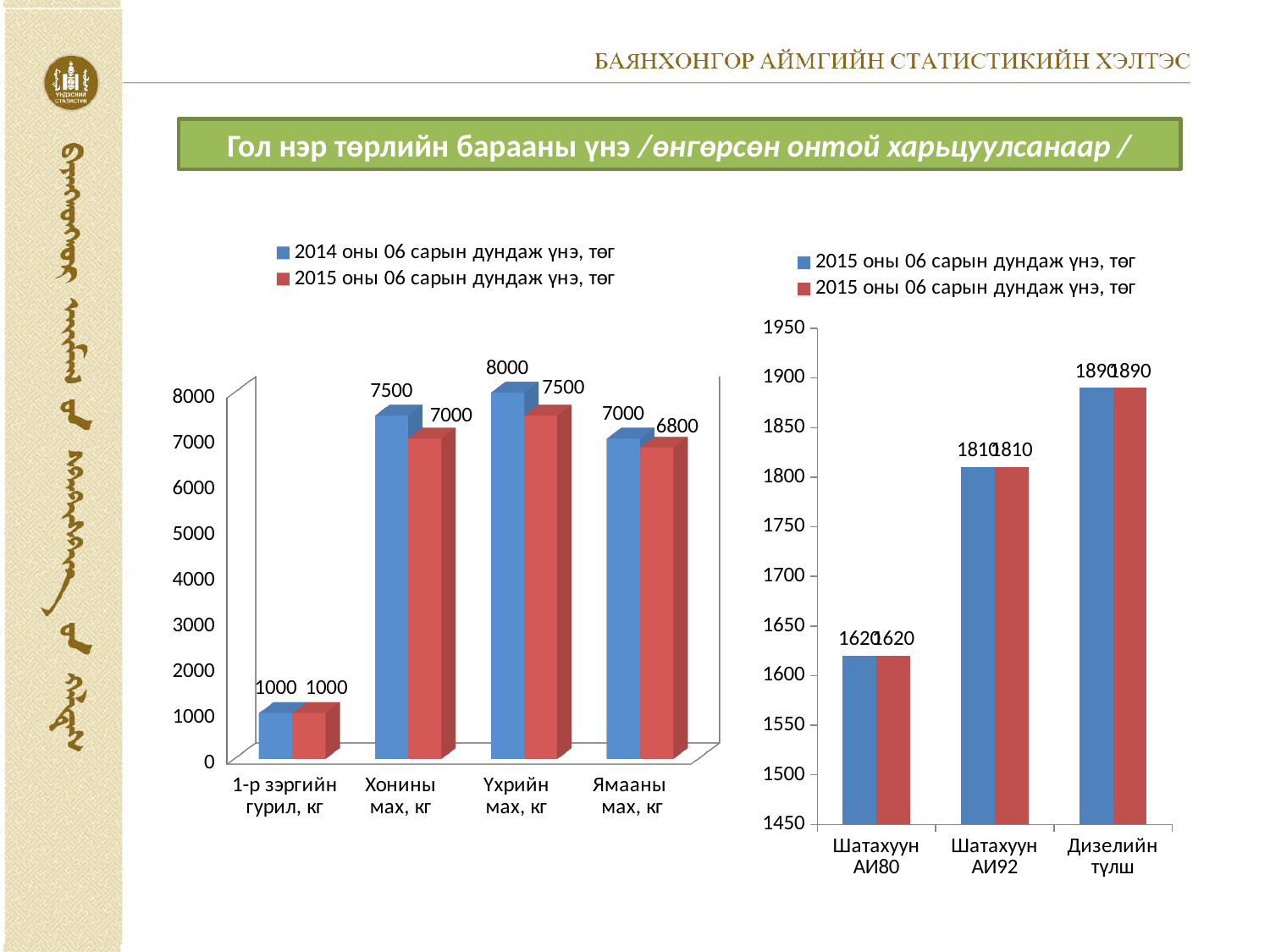
In the left chart, what is the 2015 оны 06 сарын дундаж үнэ for Ямааны мах, кг? 6800 In the left chart, what is the difference between the 2014 and 2015 values for Хонины мах, кг? 500 What kind of chart is the right chart? bar chart In the left chart, which category has the lowest 2015 оны 06 сарын дундаж үнэ? 1-р зэргийн гурил, кг In the right chart, what is the value shown for Шатахуун АИ92? 1810 How many categories are shown on the x axis of the left chart? 4 In the right chart, which category has the highest value? Дизелийн түлш In the left chart, which is larger for Ямааны мах, кг: the 2014 value or the 2015 value? 2014 value In the right chart, what is the difference between the values for Дизелийн түлш and Шатахуун АИ80? 270 In the left chart, what is the 2014 оны 06 сарын дундаж үнэ for Үхрийн мах, кг? 8000 In the right chart, do the values rise or fall from Шатахуун АИ80 to Дизелийн түлш? rise In the left chart, which category has the highest 2014 оны 06 сарын дундаж үнэ? Үхрийн мах, кг